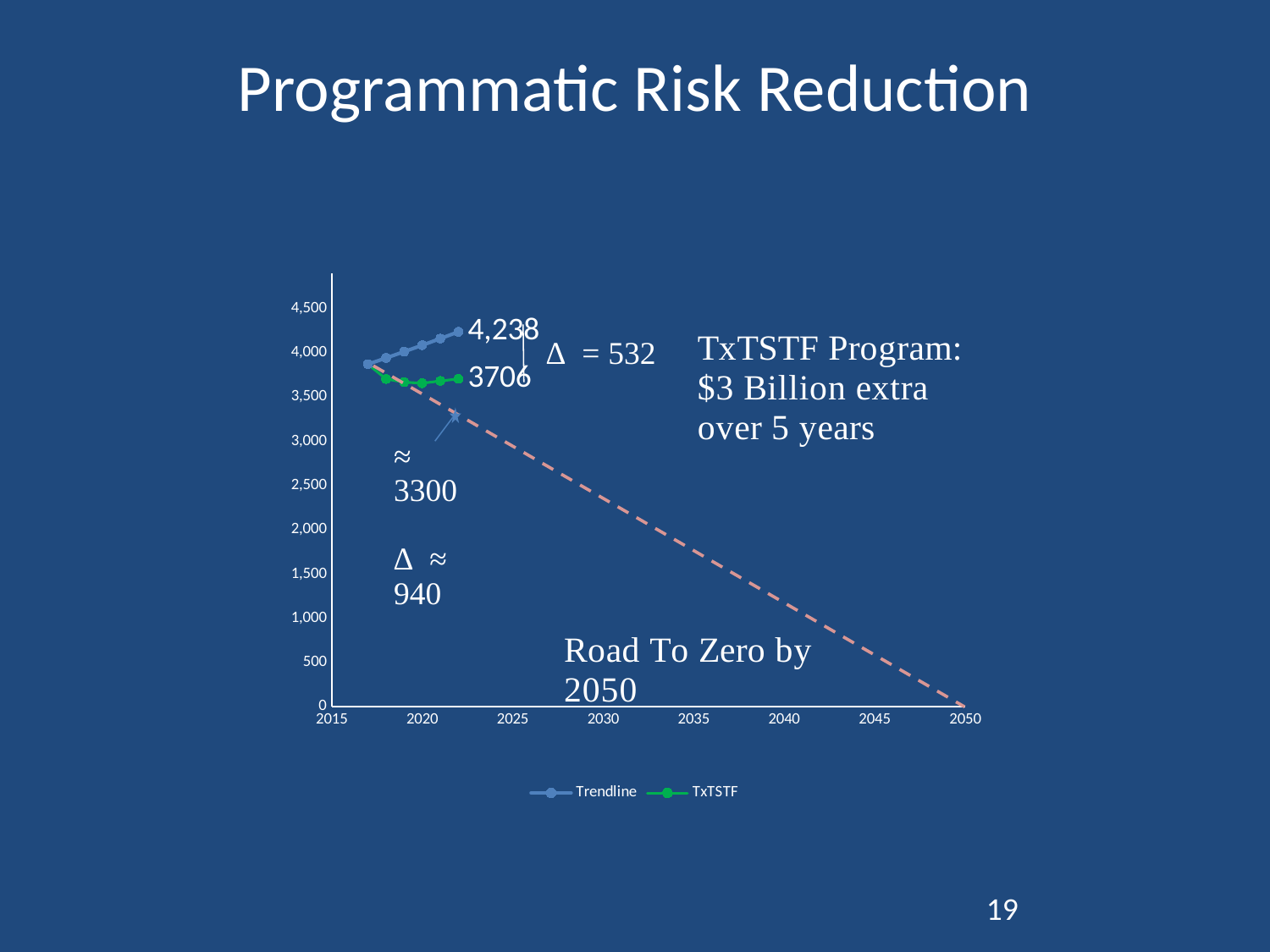
What kind of chart is shown on the slide? line chart What is the labelled final value of the TxTSTF series? 3706 Does the TxTSTF series rise or fall as the years increase? fall At the end of the plotted series, which is higher: Trendline or TxTSTF? Trendline Is the final value of the TxTSTF series greater or less than 4,000? less What is the difference between the final Trendline value (4,238) and the final TxTSTF value (3706)? 532 What is the labelled final value of the Trendline series? 4,238 How many series does the legend list? 2 Is the final value of the Trendline series greater or less than 4,000? greater What are the two series named in the legend? Trendline and TxTSTF Does the Trendline series rise or fall as the years increase? rise What is the title of the slide containing the chart? Programmatic Risk Reduction